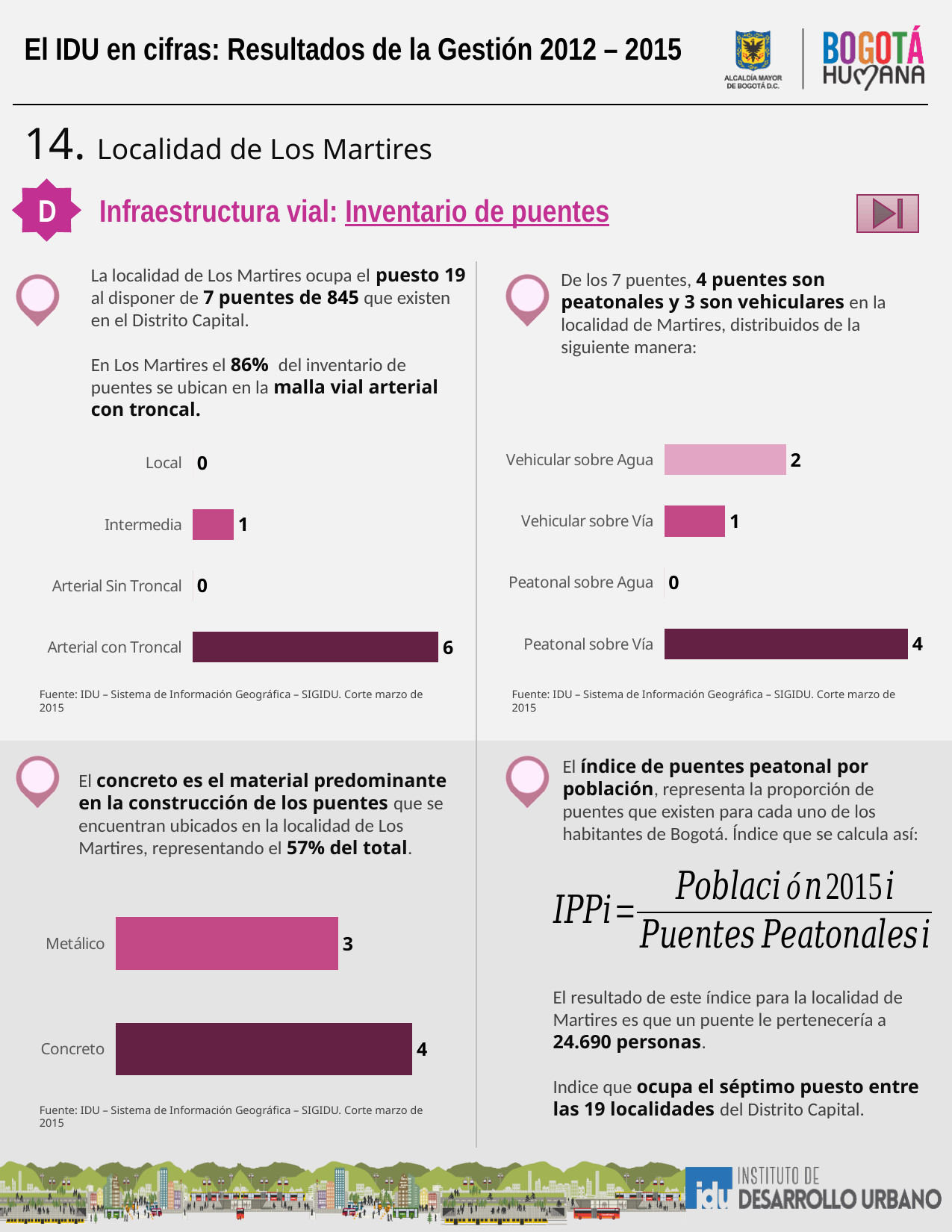
In the top-left chart, how many categories are shown? 4 In the top-left chart, what is the value for Arterial con Troncal? 6 What type of chart is the bottom-left chart? Bar chart In the bottom-left chart, what is the total of Metálico and Concreto? 7 In the top-right chart, which category has a value of 0? Peatonal sobre Agua In the bottom-left chart, which is larger, Concreto or Metálico? Concreto In the bottom-left chart, what is the value for Metálico? 3 In the top-right chart, what is the value for Vehicular sobre Agua? 2 In the top-left chart, which category has the highest value? Arterial con Troncal In the top-left chart, what is the value for Intermedia? 1 In the top-right chart, which category has the highest value? Peatonal sobre Vía In the top-right chart, what is the difference between Peatonal sobre Vía and Vehicular sobre Vía? 3